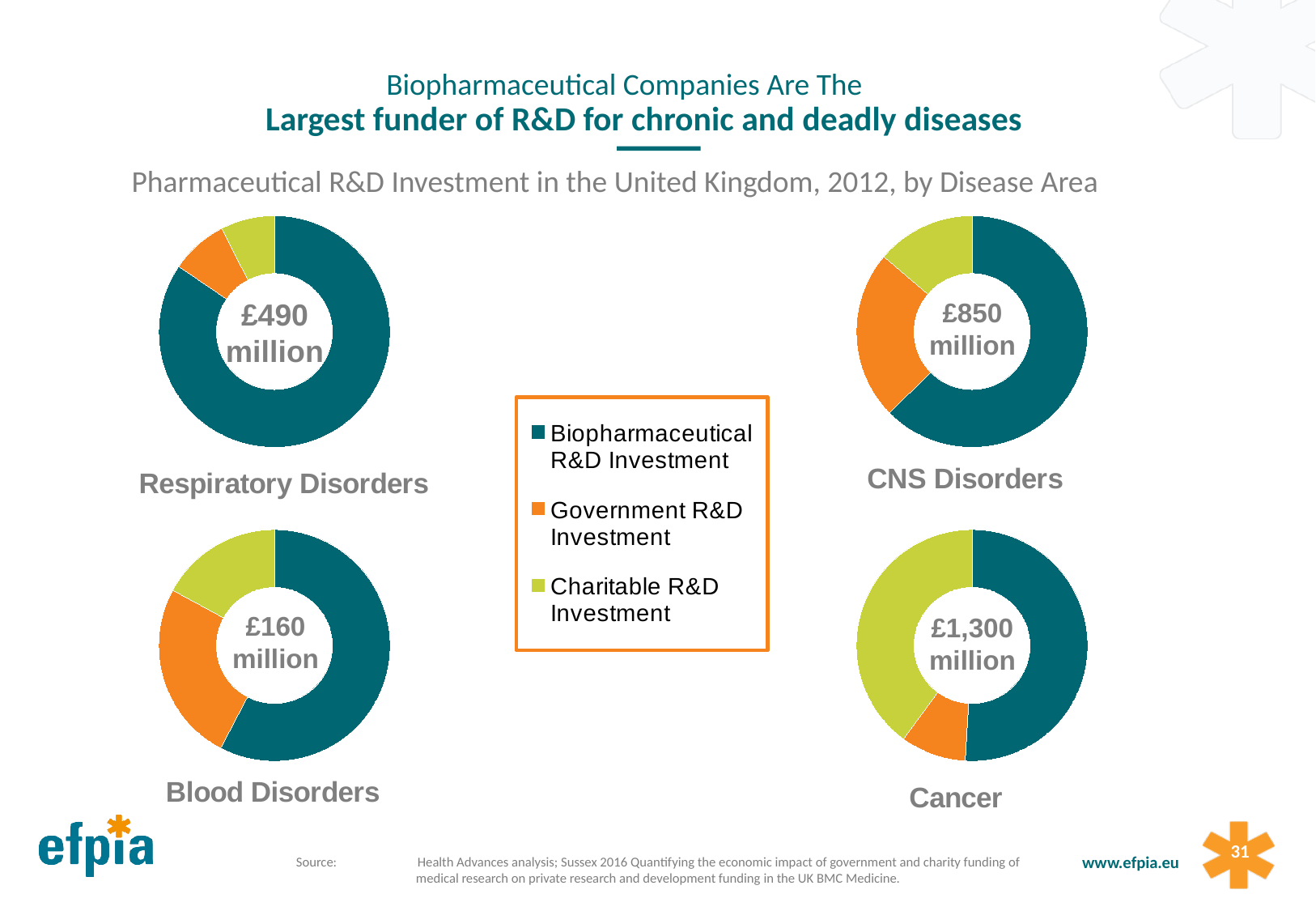
Which disease area has the smallest total R&D investment shown in its donut centre? Blood Disorders What kind of chart is used for each disease area on this slide? Donut (pie) chart In the Cancer donut chart, which funding source has the largest slice? Biopharmaceutical R&D Investment Which has a larger total R&D investment, CNS Disorders or Respiratory Disorders? CNS Disorders In the Cancer donut chart, which funding source has the smallest slice? Government R&D Investment How many series does the legend list? 3 What total is shown in the centre of the CNS Disorders donut chart? £850 million What total is shown in the centre of the Cancer donut chart? £1,300 million Which disease area has the largest total R&D investment shown in its donut centre? Cancer How many donut charts are shown on the slide? 4 What total is shown in the centre of the Blood Disorders donut chart? £160 million What total is shown in the centre of the Respiratory Disorders donut chart? £490 million